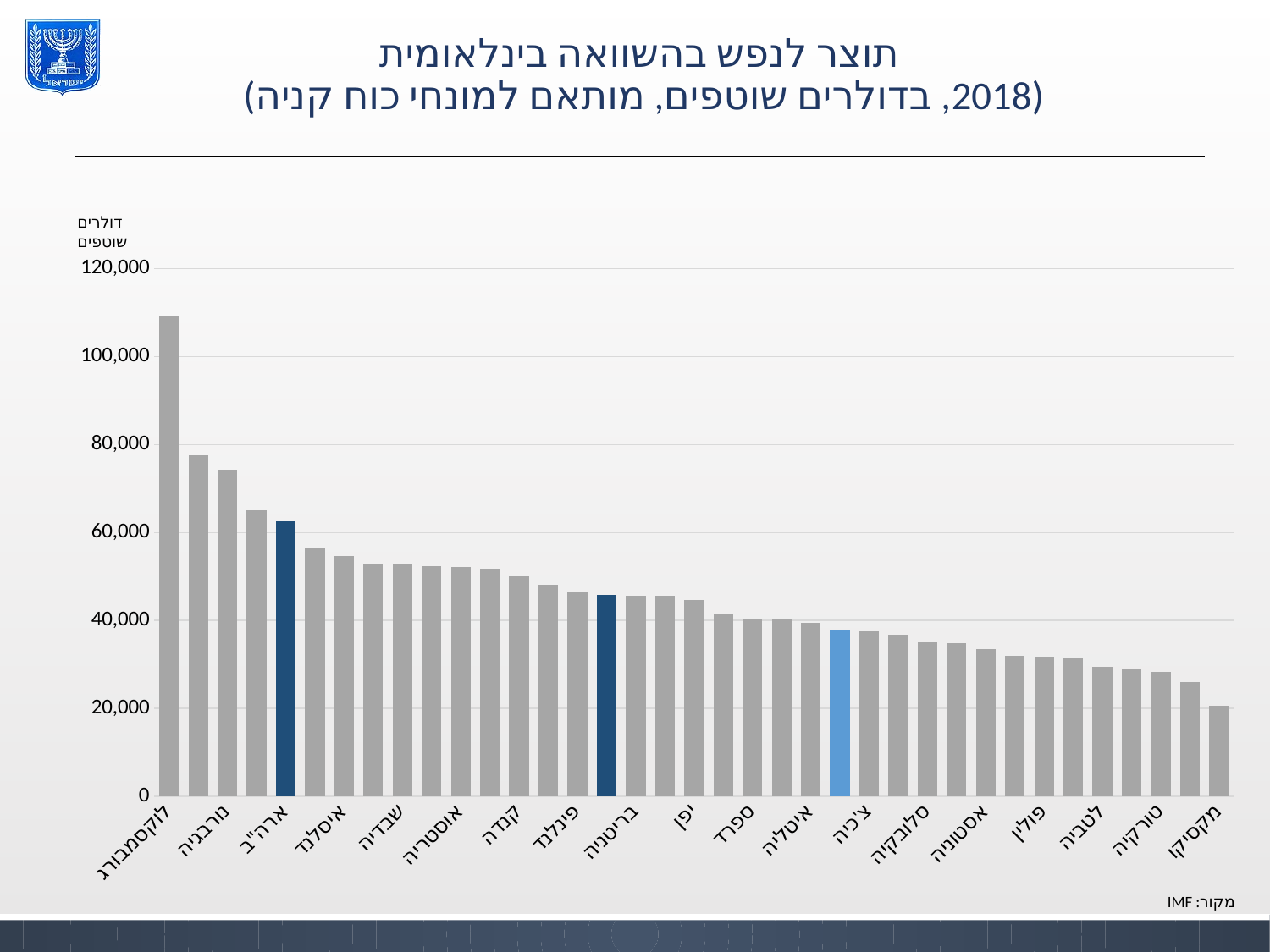
Is the value for מקסיקו greater or less than 40,000? less Is the value for יפן greater or less than 40,000? greater Which country has the lowest GDP per capita in the chart? מקסיקו Which has a higher value, נורבגיה or איסלנד? נורבגיה Is the value for צ'כיה greater or less than 40,000? less Do the bar values rise or fall from left to right along the x axis? fall Which has a higher value, קנדה or ספרד? קנדה Which country has the highest GDP per capita in the chart? לוקסמבורג What source is cited for the chart's data? IMF What kind of chart is shown on the slide? bar chart